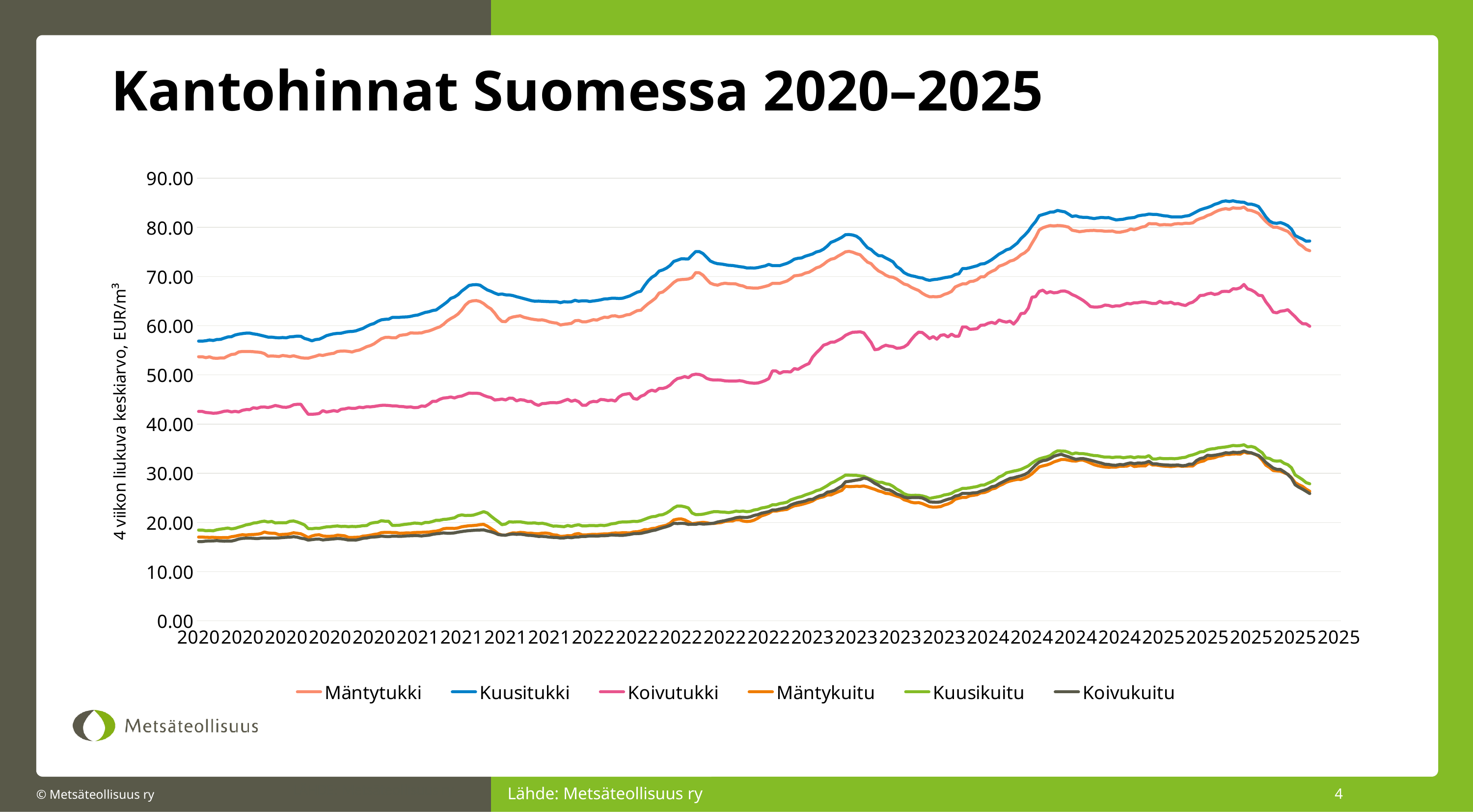
Is the value for Kuusitukki at the start of 2020 greater or less than 50? greater What is the title of the chart? Kantohinnat Suomessa 2020–2025 What is the label on the vertical axis? 4 viikon liukuva keskiarvo, EUR/m³ Is the value for Koivutukki at the end of 2025 greater or less than 70? less Which series has the highest values across the whole period? Kuusitukki What kind of chart is shown on the slide? line chart Overall, do the Koivutukki values rise or fall from 2020 to 2025? rise Is the value for Koivukuitu at the start of 2020 greater or less than 20? less Which is larger at the start of 2020, Kuusitukki or Koivutukki? Kuusitukki How many series does the legend list? 6 Which is larger at the end of 2025, Kuusikuitu or Koivukuitu? Kuusikuitu